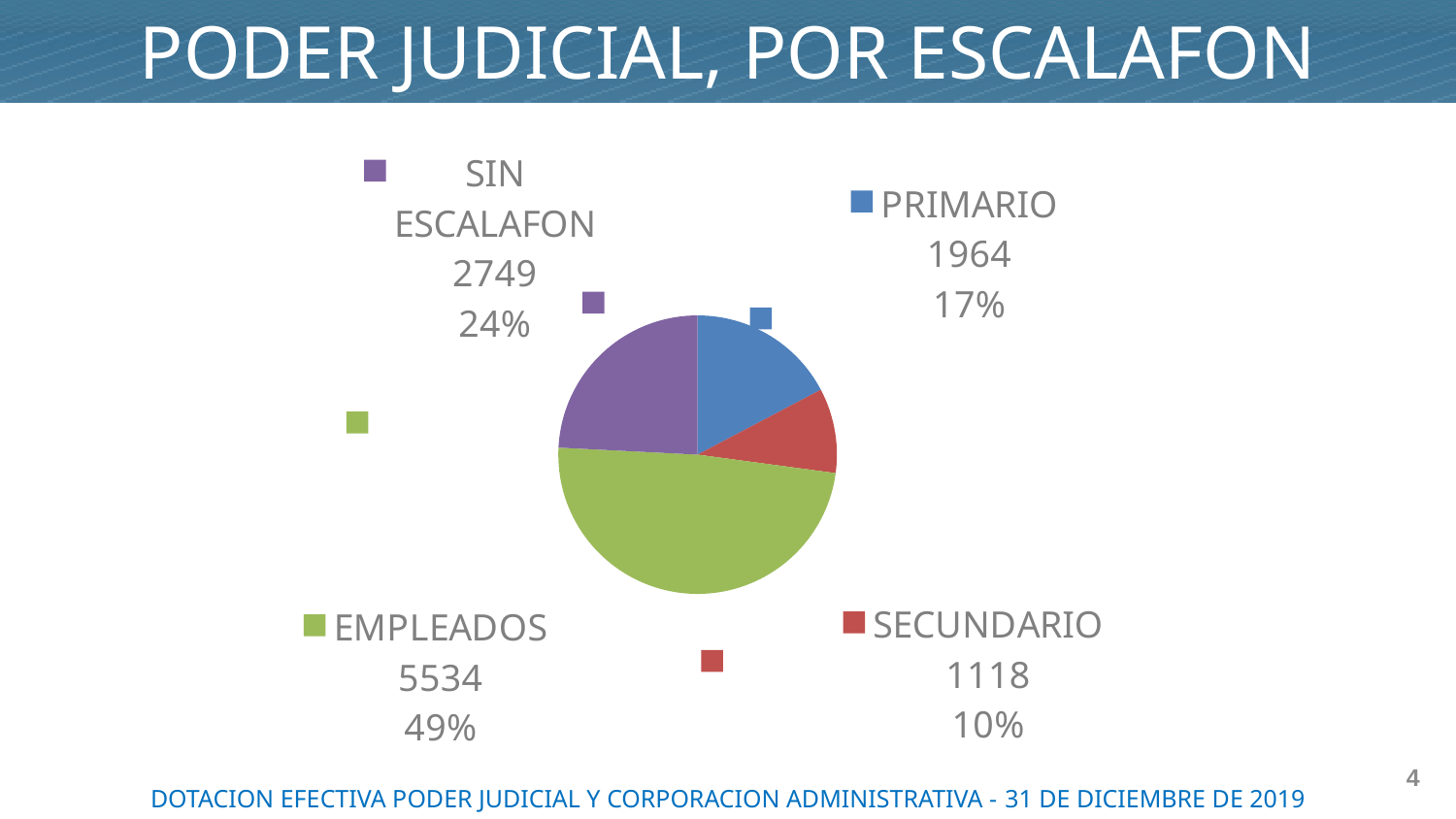
What is the value for SECUNDARIO? 1118 What is the value for EMPLEADOS? 5534 Which category has the smallest slice? SECUNDARIO What is the difference between the values for EMPLEADOS and SIN ESCALAFON? 2785 Which is larger, the value for PRIMARIO or the value for SECUNDARIO? PRIMARIO How many categories does the pie chart have? 4 Which category has the largest slice? EMPLEADOS What is the value for SIN ESCALAFON? 2749 What is the value for PRIMARIO? 1964 What kind of chart is shown on the slide? pie chart What share of the pie does SIN ESCALAFON represent? 24% What share of the pie does SECUNDARIO represent? 10%